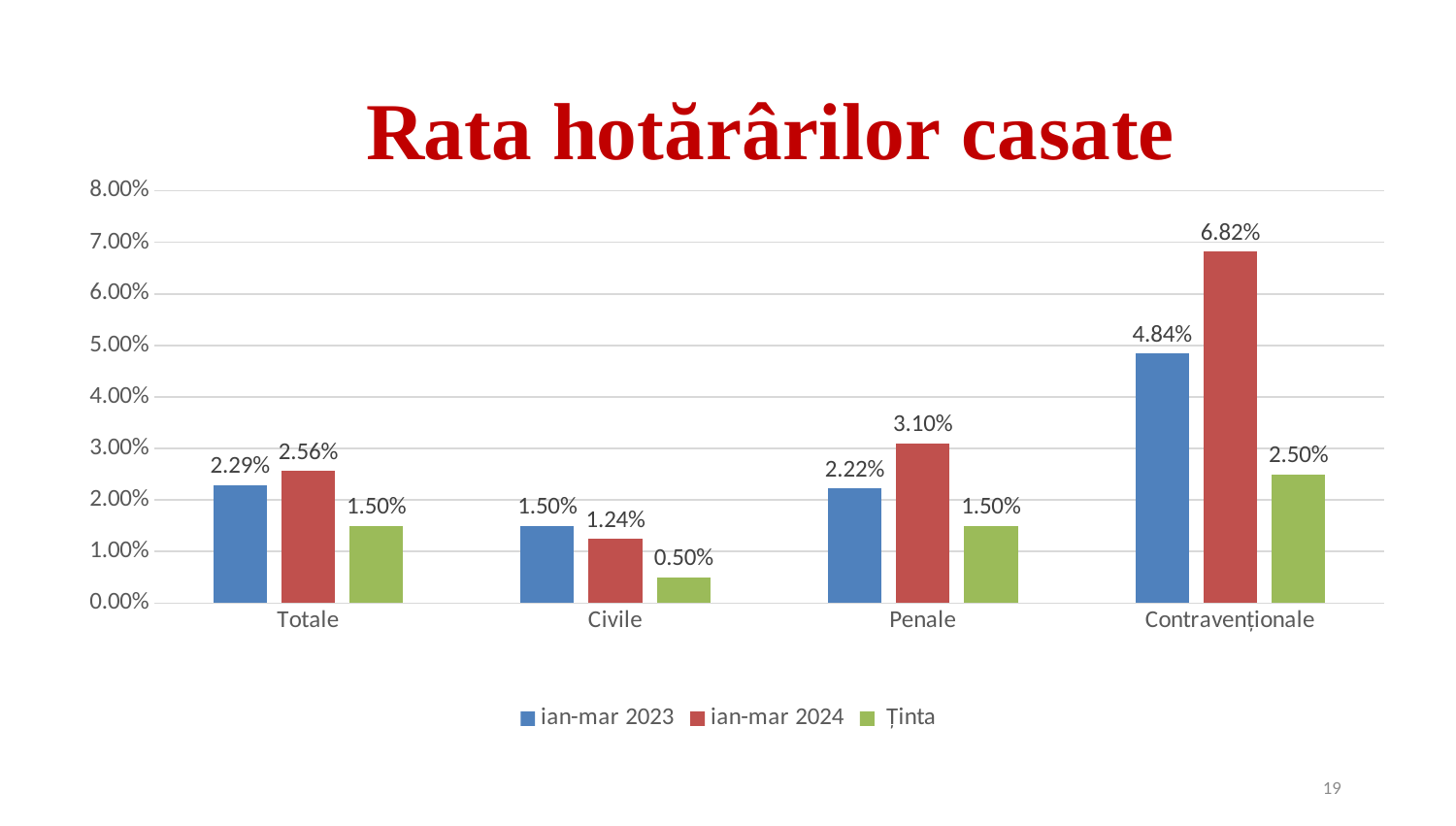
What is the ian-mar 2024 value for Contravenționale? 6.82% What is the difference between the ian-mar 2024 and ian-mar 2023 values for Contravenționale? 1.98% What is the title of the chart? Rata hotărârilor casate Which category has the highest ian-mar 2024 value? Contravenționale What kind of chart is shown on the slide? bar chart How many series does the legend list? 3 What is the Ținta value for Penale? 1.50% Which is larger for Civile: the ian-mar 2023 value or the ian-mar 2024 value? ian-mar 2023 What is the ian-mar 2023 value for Civile? 1.50% Is the ian-mar 2023 value for Contravenționale greater or less than 4.00%? greater How many categories are shown on the x axis? 4 Which category has the lowest Ținta value? Civile